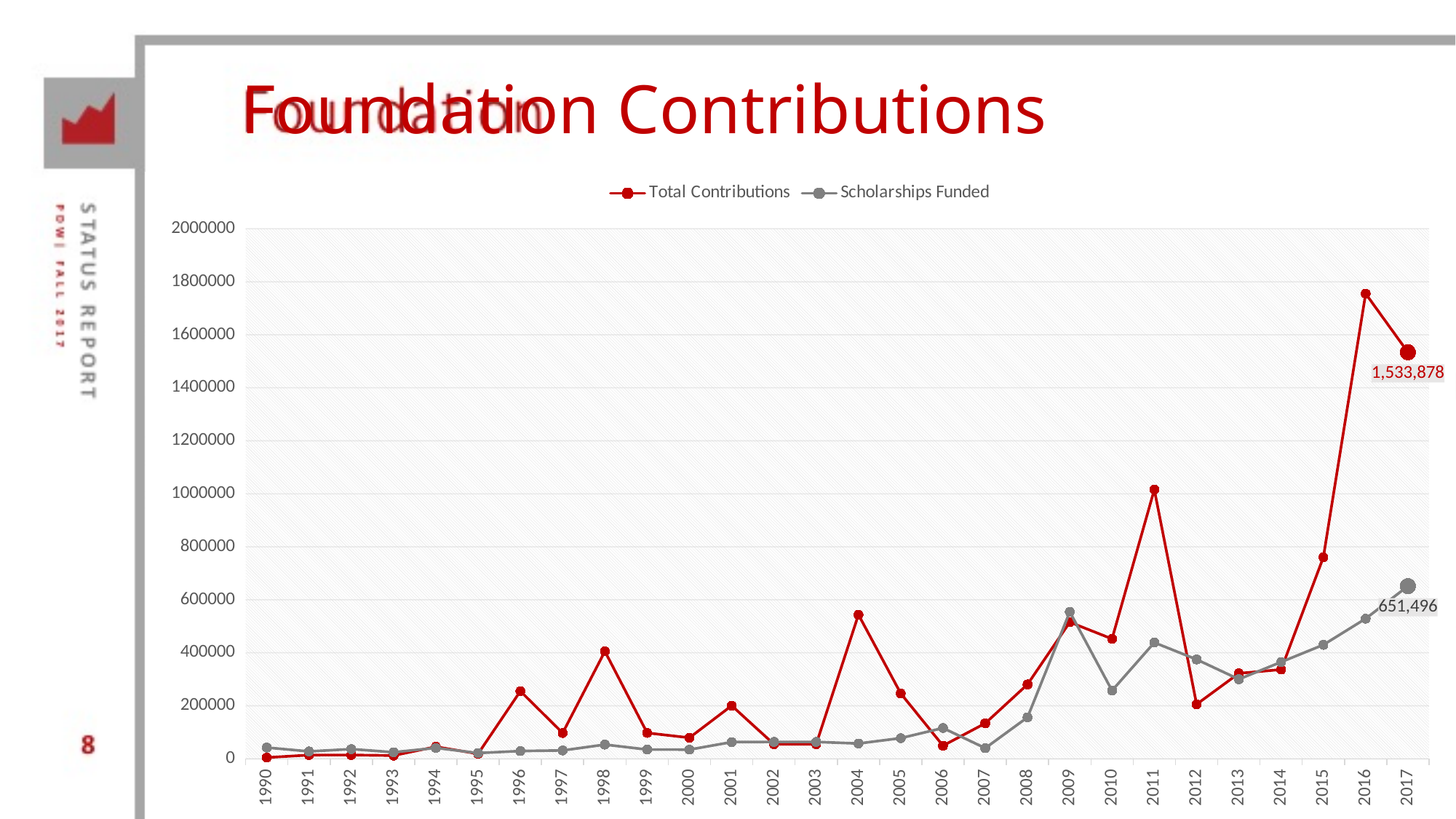
What is the value of Scholarships Funded in 2017? 651,496 What is the difference between Total Contributions and Scholarships Funded in 2017? 882,382 In 2012, which is larger: Total Contributions or Scholarships Funded? Scholarships Funded In which year is Total Contributions highest? 2016 Is the value for Total Contributions in 2016 greater or less than 1600000? greater What kind of chart is shown on the slide? Line chart What is the value of Total Contributions in 2017? 1,533,878 Is the value for Scholarships Funded in 2009 greater or less than 400000? greater In which year is Scholarships Funded highest? 2017 How many years are shown on the x axis? 28 How many series does the legend list? 2 Is the value for Total Contributions in 2004 greater or less than 600000? less